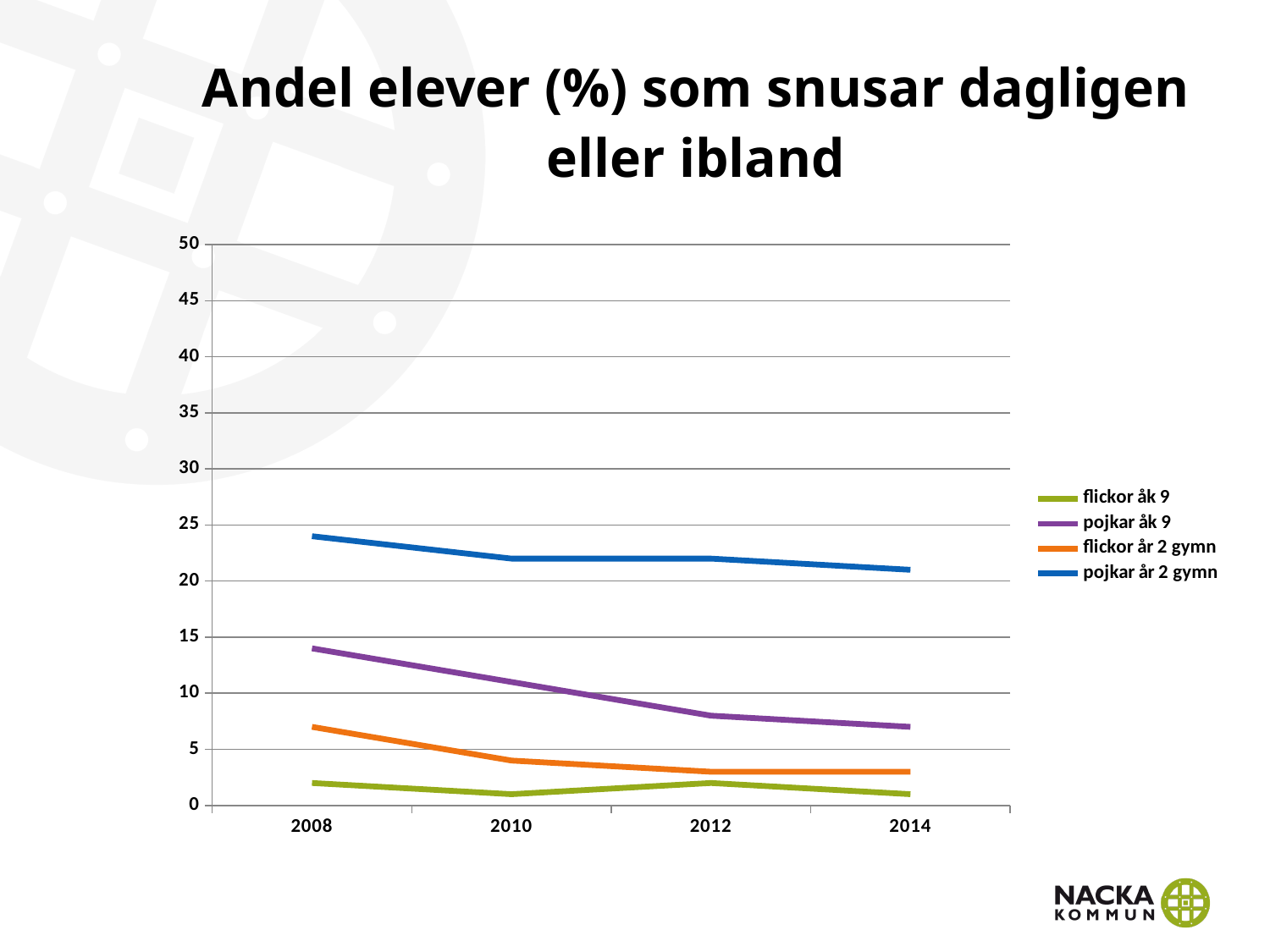
What kind of chart is shown on the slide? line chart Is the value for flickor år 2 gymn in 2008 greater or less than 5? greater Does the value for pojkar åk 9 rise or fall from 2008 to 2014? fall Is the value for pojkar år 2 gymn in 2008 greater or less than 20? greater In 2010, which is larger: pojkar åk 9 or flickor år 2 gymn? pojkar åk 9 How many series does the legend list? 4 Which series has the highest value in 2014? pojkar år 2 gymn Is the value for pojkar åk 9 in 2014 greater or less than 10? less Which series has the lowest value in 2008? flickor åk 9 What is the title of the chart? Andel elever (%) som snusar dagligen eller ibland How many years are shown on the x axis? 4